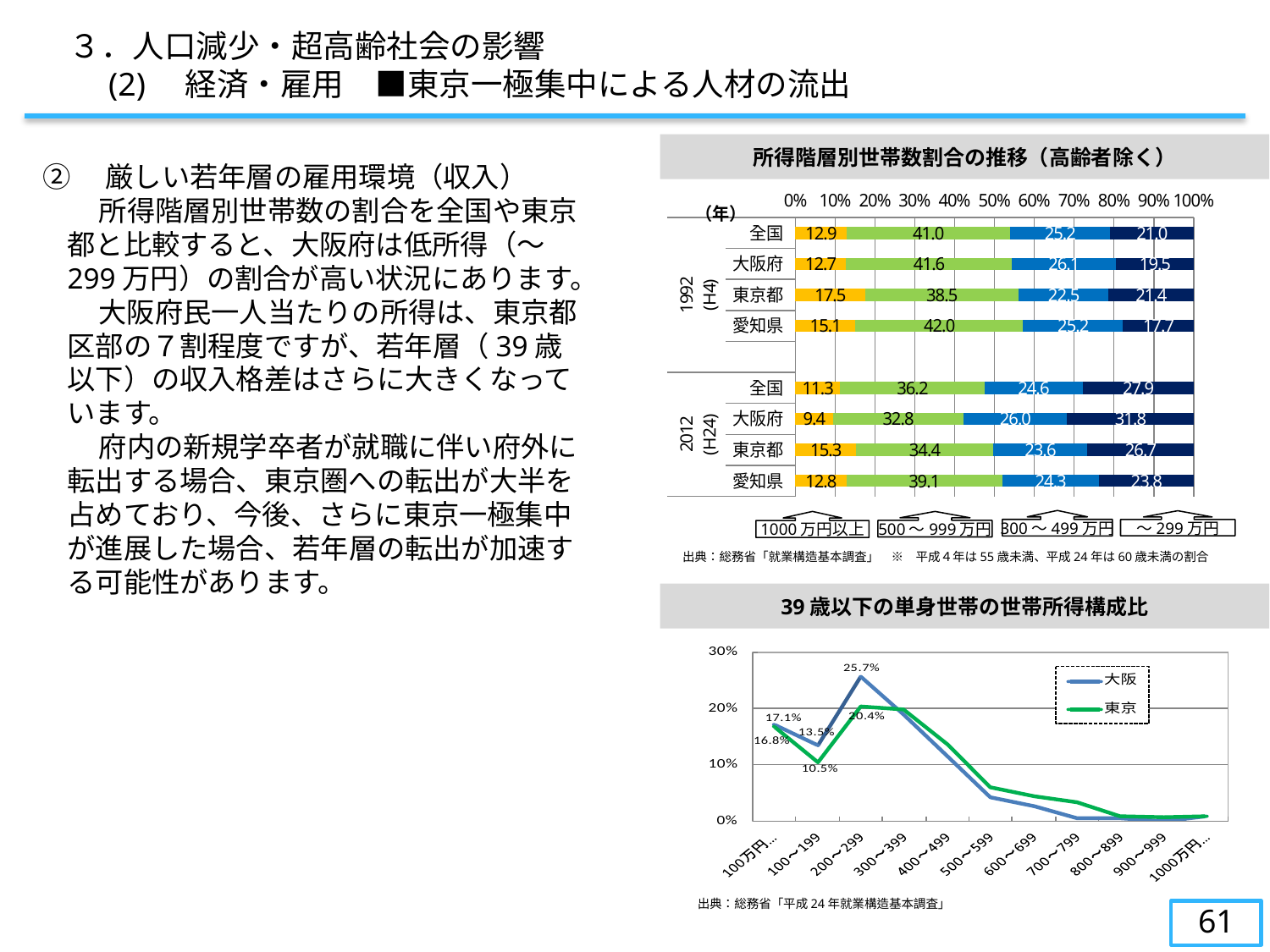
How many series does the legend of the bottom chart 39歳以下の単身世帯の世帯所得構成比 list? 2 In the bottom chart 39歳以下の単身世帯の世帯所得構成比, what is the value for 大阪 at 200～299? 25.7% How many income categories are shown on the x axis of the bottom chart 39歳以下の単身世帯の世帯所得構成比? 11 In the top chart 所得階層別世帯数割合の推移, which has the larger ～299万円 share in 2012 (H24), 大阪府 or 東京都? 大阪府 What kind of chart is the top chart titled 所得階層別世帯数割合の推移（高齢者除く）? Stacked bar chart In the top chart 所得階層別世帯数割合の推移, which region has the lowest 1000万円以上 share in 2012 (H24)? 大阪府 In the top chart 所得階層別世帯数割合の推移, what is the ～299万円 share for 大阪府 in 2012 (H24)? 31.8 In the bottom chart 39歳以下の単身世帯の世帯所得構成比, what is the value for 東京 at 200～299? 20.4% In the top chart 所得階層別世帯数割合の推移, what is the 1000万円以上 share for 東京都 in 1992 (H4)? 17.5 In the top chart 所得階層別世帯数割合の推移, by how much did the ～299万円 share for 大阪府 increase from 1992 to 2012? 12.3 In the bottom chart 39歳以下の単身世帯の世帯所得構成比, is the value for 大阪 at 500～599 greater or less than 10%? less What are the legend entries of the bottom chart 39歳以下の単身世帯の世帯所得構成比? 大阪, 東京